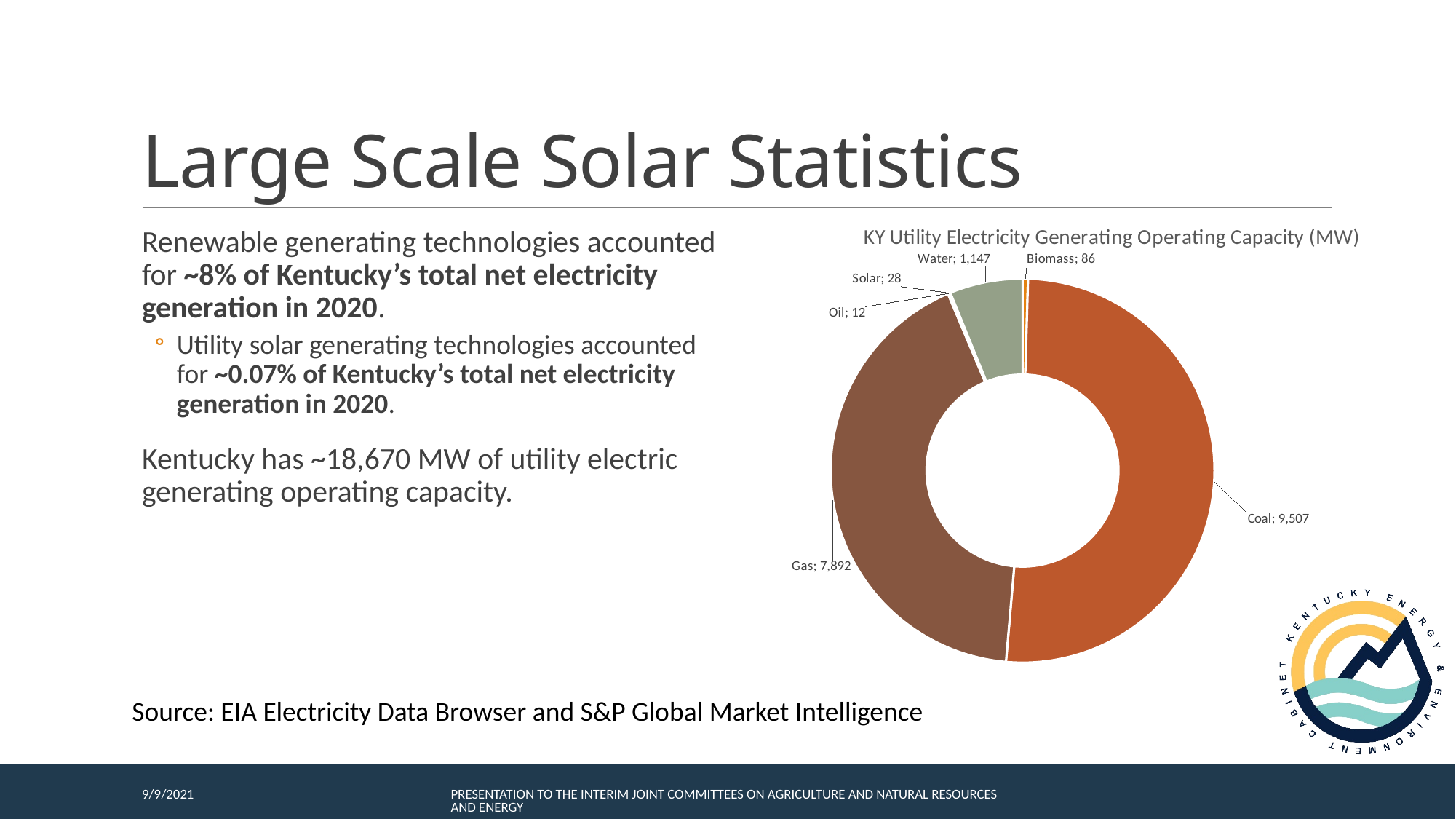
What is the operating capacity for Oil in the chart? 12 How many categories are shown in the chart? 6 What is the operating capacity for Gas in the chart? 7,892 What is the difference between the Water and Biomass operating capacities? 1,061 What is the operating capacity for Solar in the chart? 28 What is the title of the chart? KY Utility Electricity Generating Operating Capacity (MW) Which category has the smallest operating capacity in the chart? Oil What is the operating capacity for Water in the chart? 1,147 What is the difference between the Coal and Gas operating capacities? 1,615 What is the operating capacity for Coal in the chart? 9,507 Which has a larger operating capacity, Biomass or Solar? Biomass Which category has the largest operating capacity in the chart? Coal